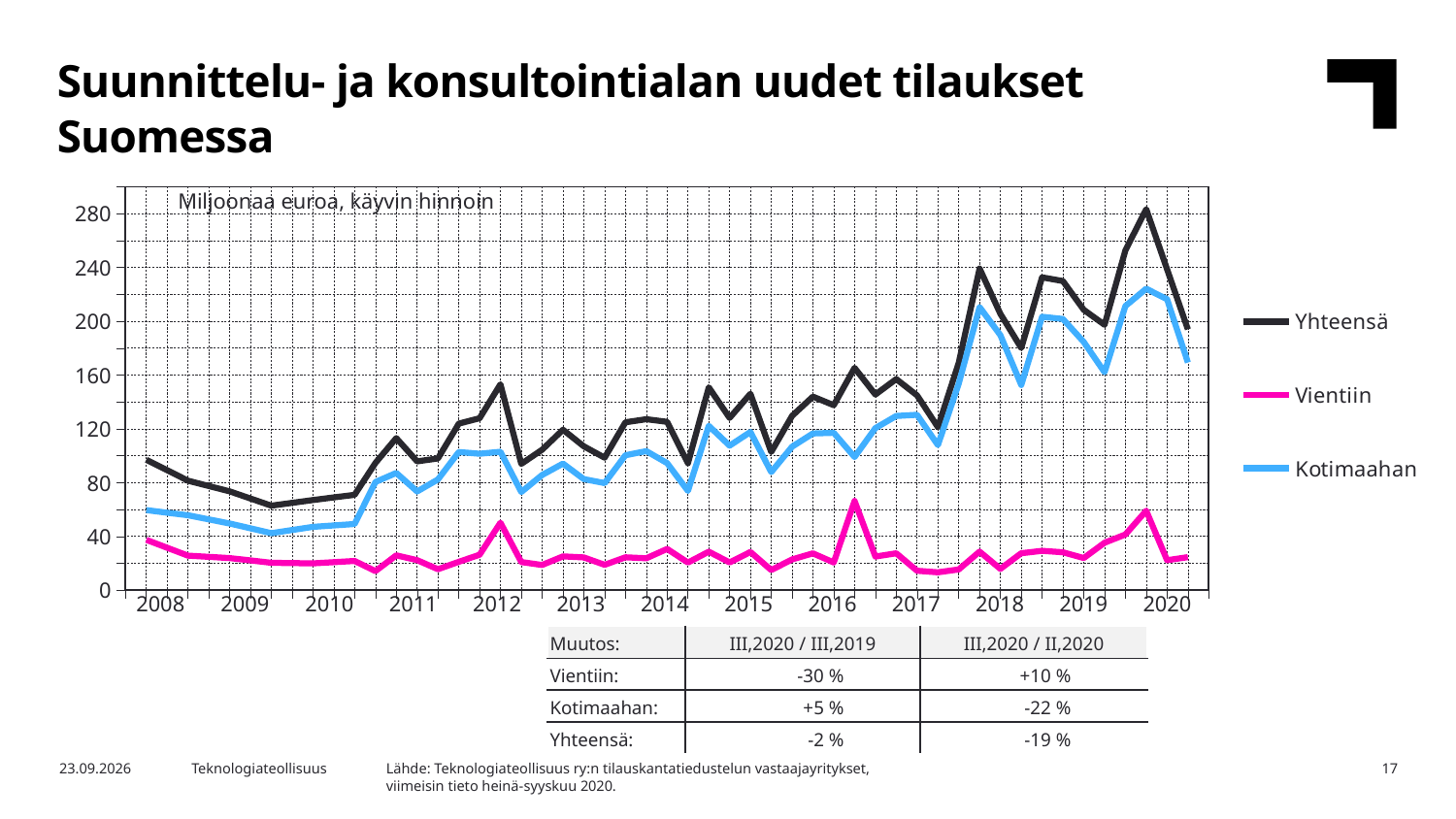
What unit label is printed inside the chart area? Miljoonaa euroa, käyvin hinnoin Is the value of Kotimaahan at the start of 2008 greater or less than 80? less Which series has the lowest values across the whole chart? Vientiin Is the value of Yhteensä at the start of 2008 greater or less than 120? less Which series is higher throughout the chart, Vientiin or Kotimaahan? Kotimaahan Does the Yhteensä line overall rise or fall from 2008 to 2020? Rise How many series does the chart legend list? 3 Is the highest point of the Kotimaahan line greater or less than 200? greater What are the three series named in the chart legend? Yhteensä, Vientiin, Kotimaahan What kind of chart is shown on the slide? Line chart